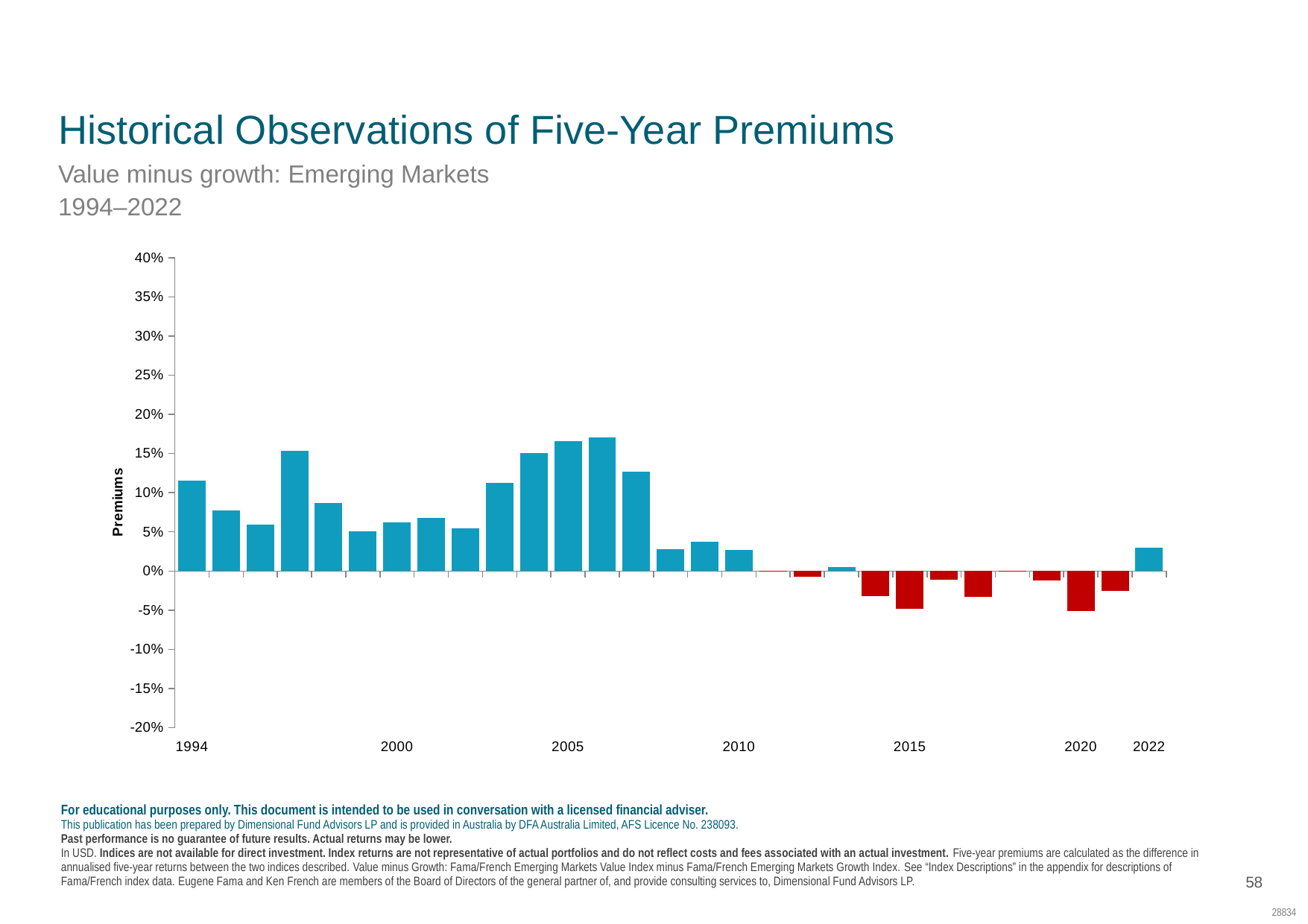
Is the value for 2015 greater or less than 0%? less What is the label on the vertical axis of the chart? Premiums Is the value for 2006 greater or less than 15%? greater Do the values rise or fall from 2003 to 2006? rise Is the value for 2020 greater or less than 0%? less Which is larger, the value for 1994 or the value for 1995? 1994 What is the title of the chart on the slide? Historical Observations of Five-Year Premiums What kind of chart is shown on the slide? bar chart Which is larger, the value for 2004 or the value for 2008? 2004 How many yearly bars are plotted in the chart (1994 through 2022)? 29